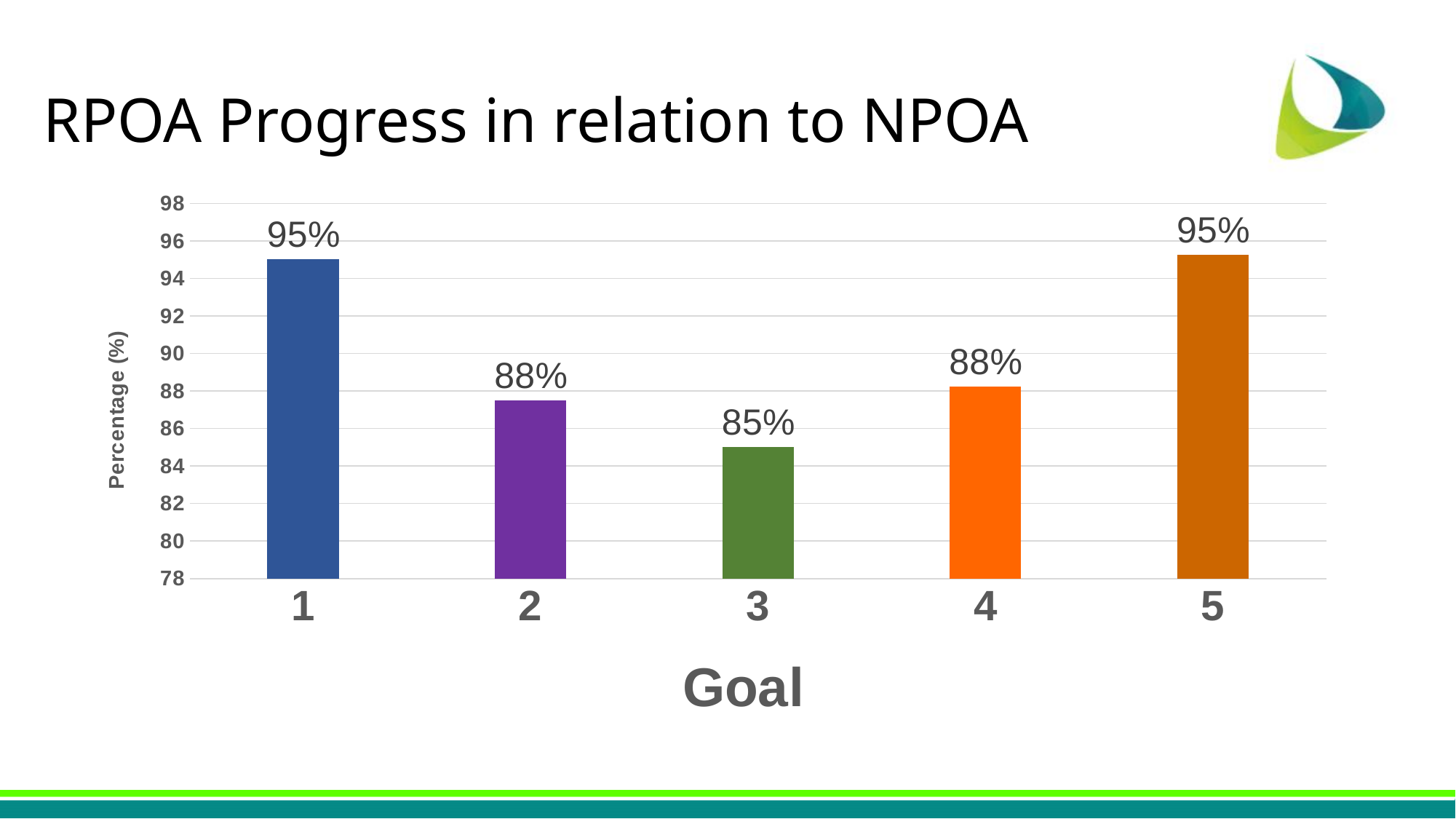
What is the difference between the values for Goal 1 and Goal 3? 10 percentage points What is the value for Goal 4? 88% What is the title of the slide? RPOA Progress in relation to NPOA Is the value for Goal 3 greater or less than 86? less How many goals are shown on the x axis? 5 Is the value for Goal 5 greater or less than 90? greater Which goal has the lowest percentage? Goal 3 What is the difference between the values for Goal 2 and Goal 3? 3 percentage points Which is larger, the value for Goal 1 or the value for Goal 2? Goal 1 What is the value for Goal 1? 95% What kind of chart is shown on the slide? bar chart What is the value for Goal 3? 85%